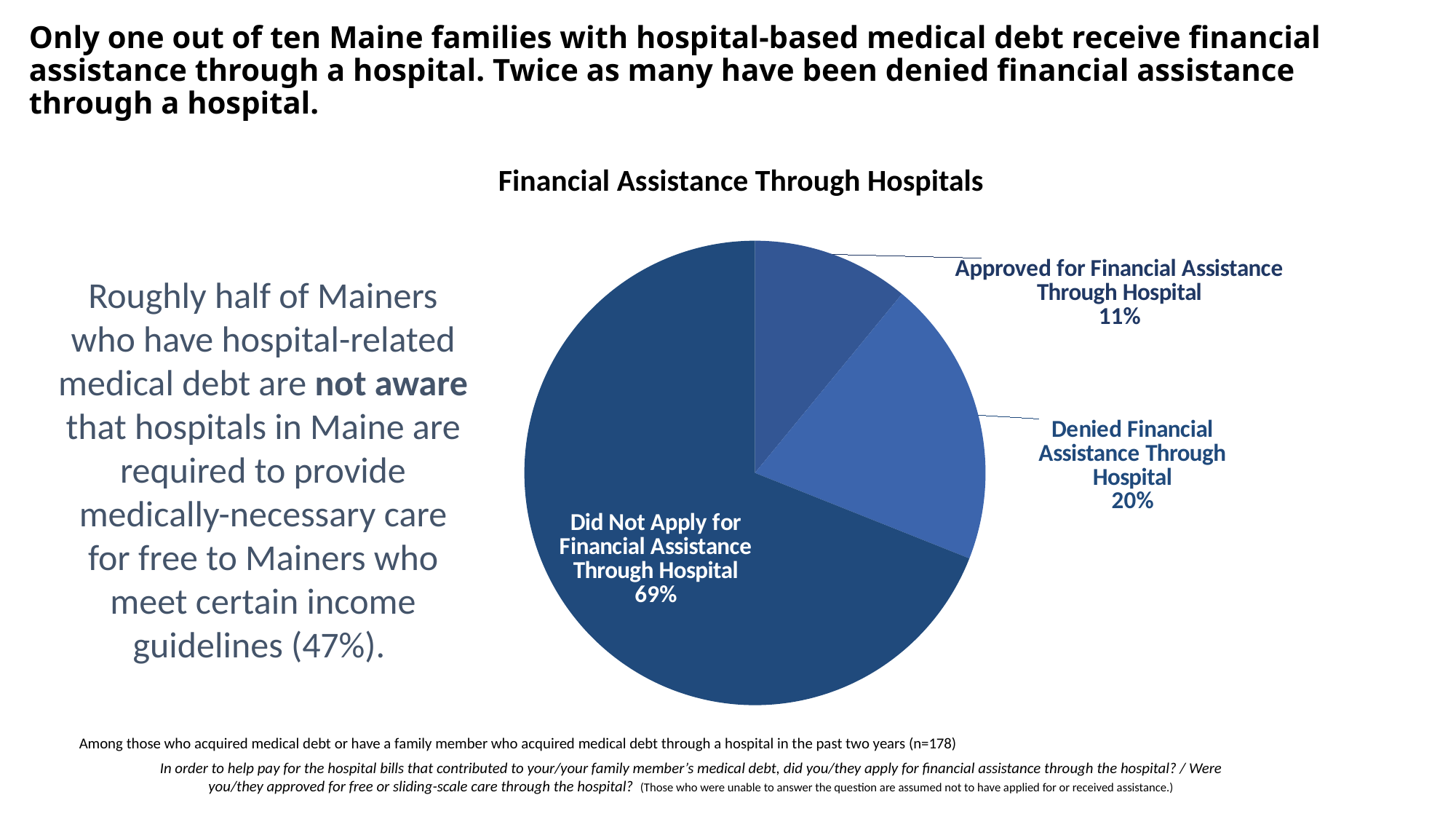
What is the title of the chart? Financial Assistance Through Hospitals What percentage were denied financial assistance through a hospital? 20% What is the combined share of those who were approved or denied financial assistance? 31% What percentage did not apply for financial assistance through a hospital? 69% Which is larger: the share denied financial assistance or the share approved? Denied Financial Assistance Through Hospital Which slice of the pie chart is the smallest? Approved for Financial Assistance Through Hospital Which slice of the pie chart is the largest? Did Not Apply for Financial Assistance Through Hospital What is the difference in percentage points between those who did not apply and those who were denied? 49 What is the difference in percentage points between those denied and those approved for financial assistance? 9 How many slices does the pie chart have? 3 What percentage were approved for financial assistance through a hospital? 11% What type of chart is shown on the slide? Pie chart